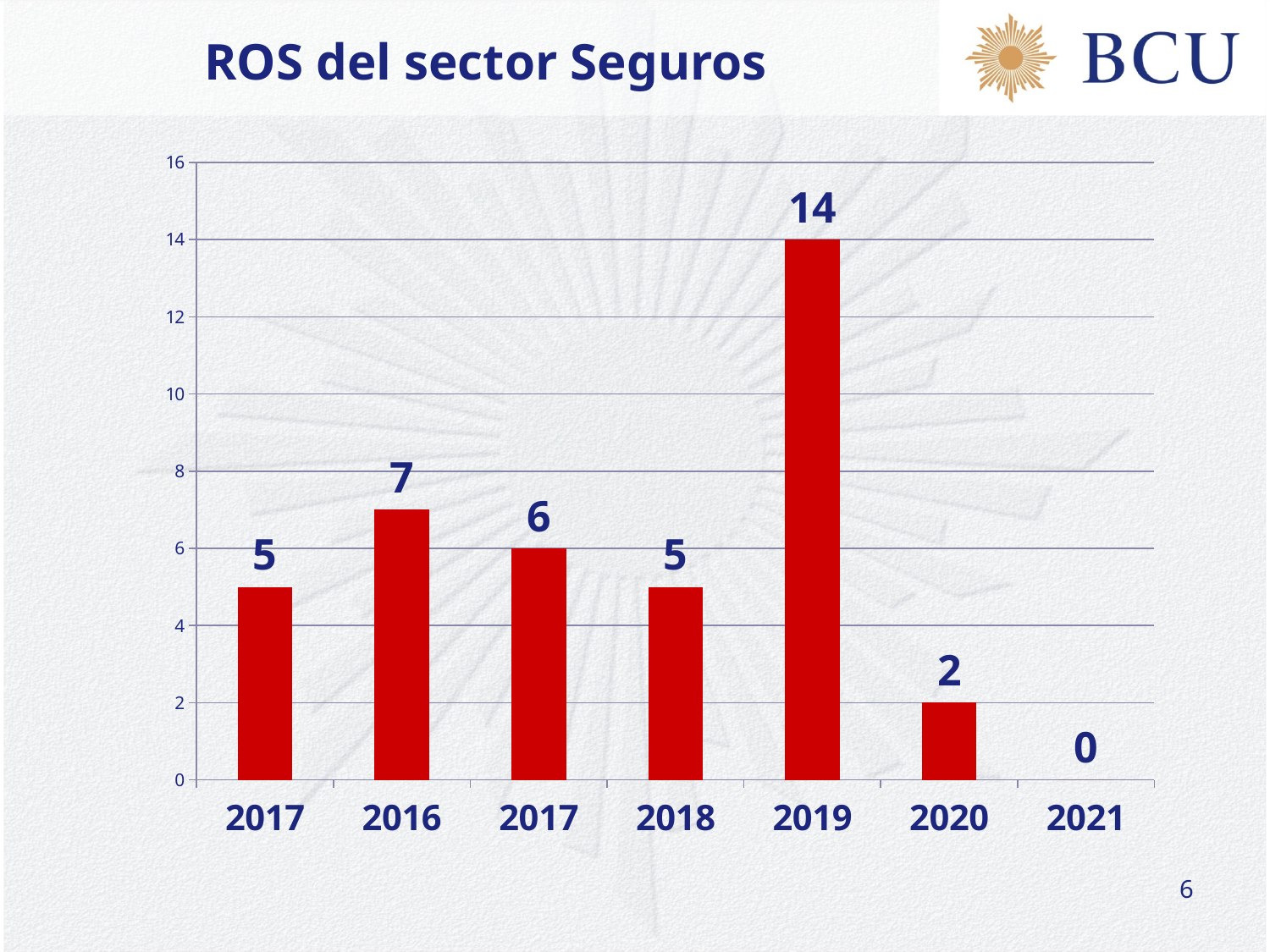
What is the value for 2021? 0 Which is larger, the value for 2016 or the value for 2018? 2016 What is the difference between the values for 2019 and 2020? 12 What is the title of the slide? ROS del sector Seguros What is the value for 2018? 5 Which year has the highest value? 2019 What is the value for 2016? 7 What kind of chart is shown on the slide? Bar chart What is the value for 2019? 14 Which year has the lowest value? 2021 How many bars (categories) are shown on the x axis? 7 What is the value for 2020? 2